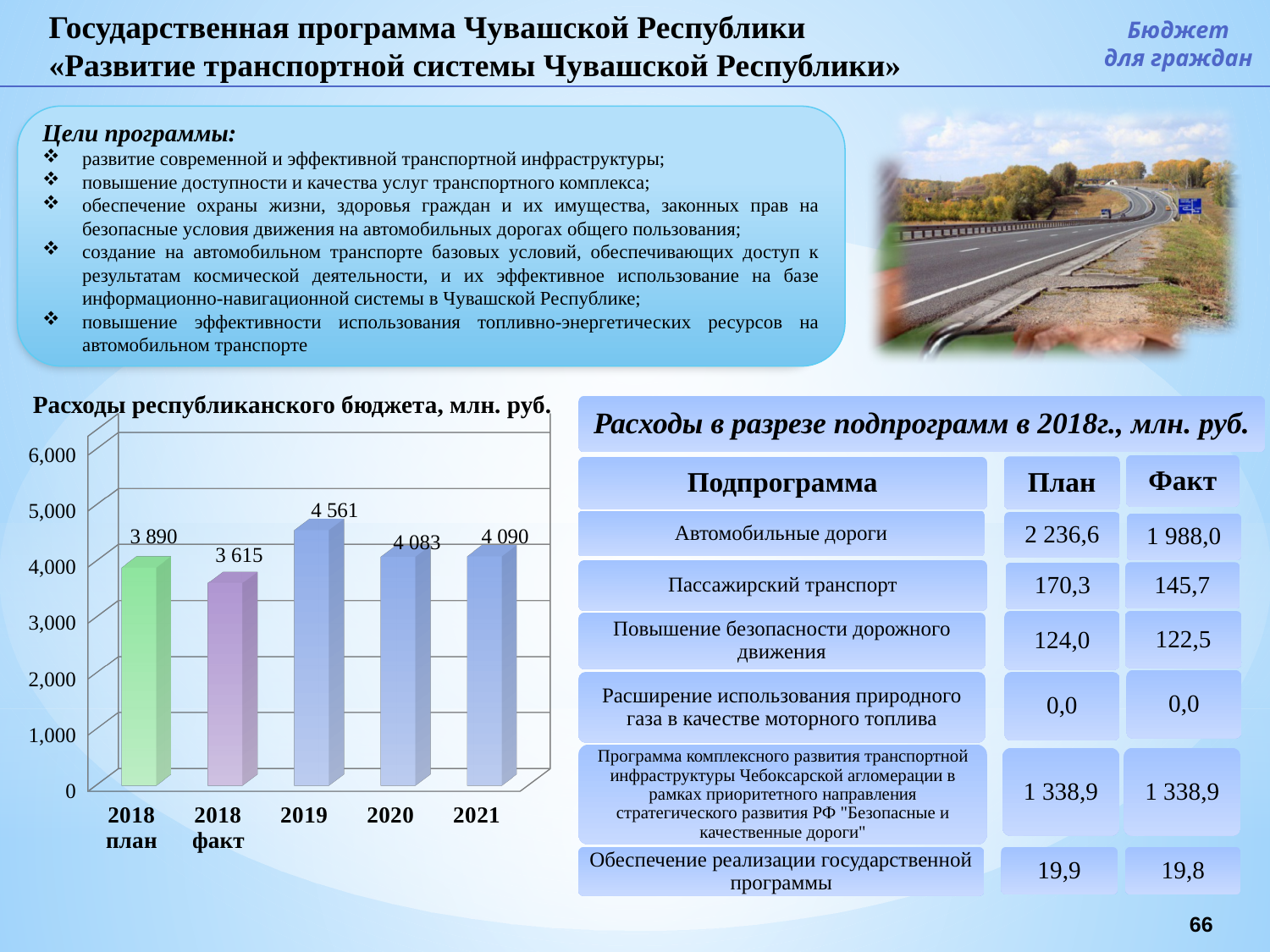
What is the value for '2018 факт' in the chart 'Расходы республиканского бюджета, млн. руб.'? 3 615 What is the value for 2019 in the chart 'Расходы республиканского бюджета, млн. руб.'? 4 561 In the chart 'Расходы республиканского бюджета, млн. руб.', what is the difference between the 2019 and 2020 values? 478 In the chart 'Расходы республиканского бюджета, млн. руб.', what is the difference between the '2018 план' and '2018 факт' values? 275 Which category has the lowest value in the chart 'Расходы республиканского бюджета, млн. руб.'? 2018 факт What is the value for '2018 план' in the chart 'Расходы республиканского бюджета, млн. руб.'? 3 890 Which category has the highest value in the chart 'Расходы республиканского бюджета, млн. руб.'? 2019 What is the value for 2021 in the chart 'Расходы республиканского бюджета, млн. руб.'? 4 090 In the chart 'Расходы республиканского бюджета, млн. руб.', is the value for 2020 greater or less than 4,000? greater How many bars are shown in the chart 'Расходы республиканского бюджета, млн. руб.'? 5 What type of chart is 'Расходы республиканского бюджета, млн. руб.'? bar chart In the chart 'Расходы республиканского бюджета, млн. руб.', which is larger: the value for 2019 or the value for 2021? 2019